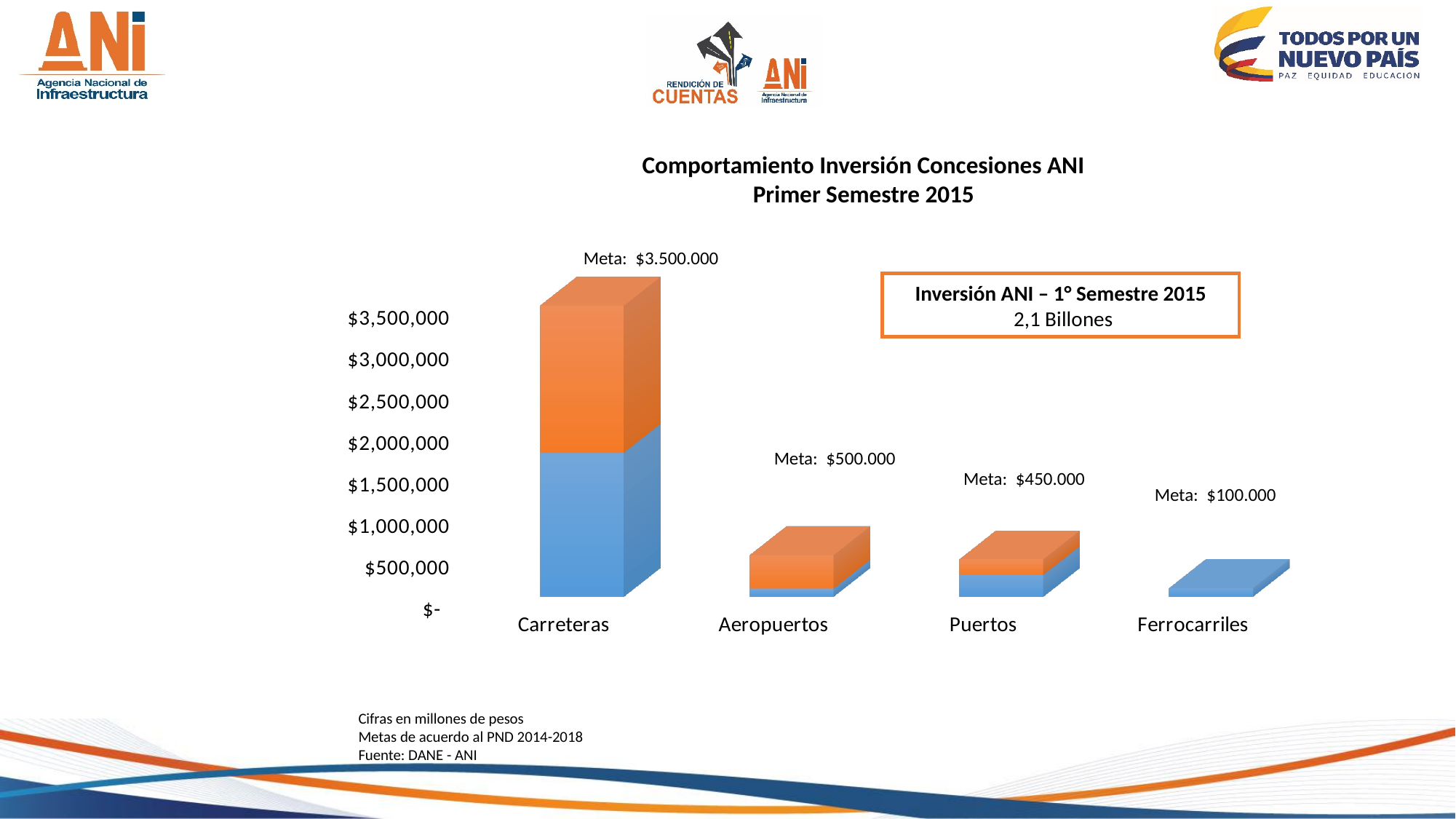
Is the total bar for Ferrocarriles greater or less than $500,000? less What is the title of the chart? Comportamiento Inversión Concesiones ANI Primer Semestre 2015 What is the Meta value shown for Aeropuertos? $500.000 Is the total bar for Carreteras greater or less than $3,000,000? greater What is the Meta value shown for Ferrocarriles? $100.000 Which category has the tallest bar? Carreteras Which has a higher Meta, Aeropuertos or Puertos? Aeropuertos What is the difference between the Meta for Carreteras and the Meta for Aeropuertos? $3.000.000 Which category has the shortest bar? Ferrocarriles What is the Meta value shown for Puertos? $450.000 How many categories are shown on the x axis? 4 What is the Meta value shown for Carreteras? $3.500.000